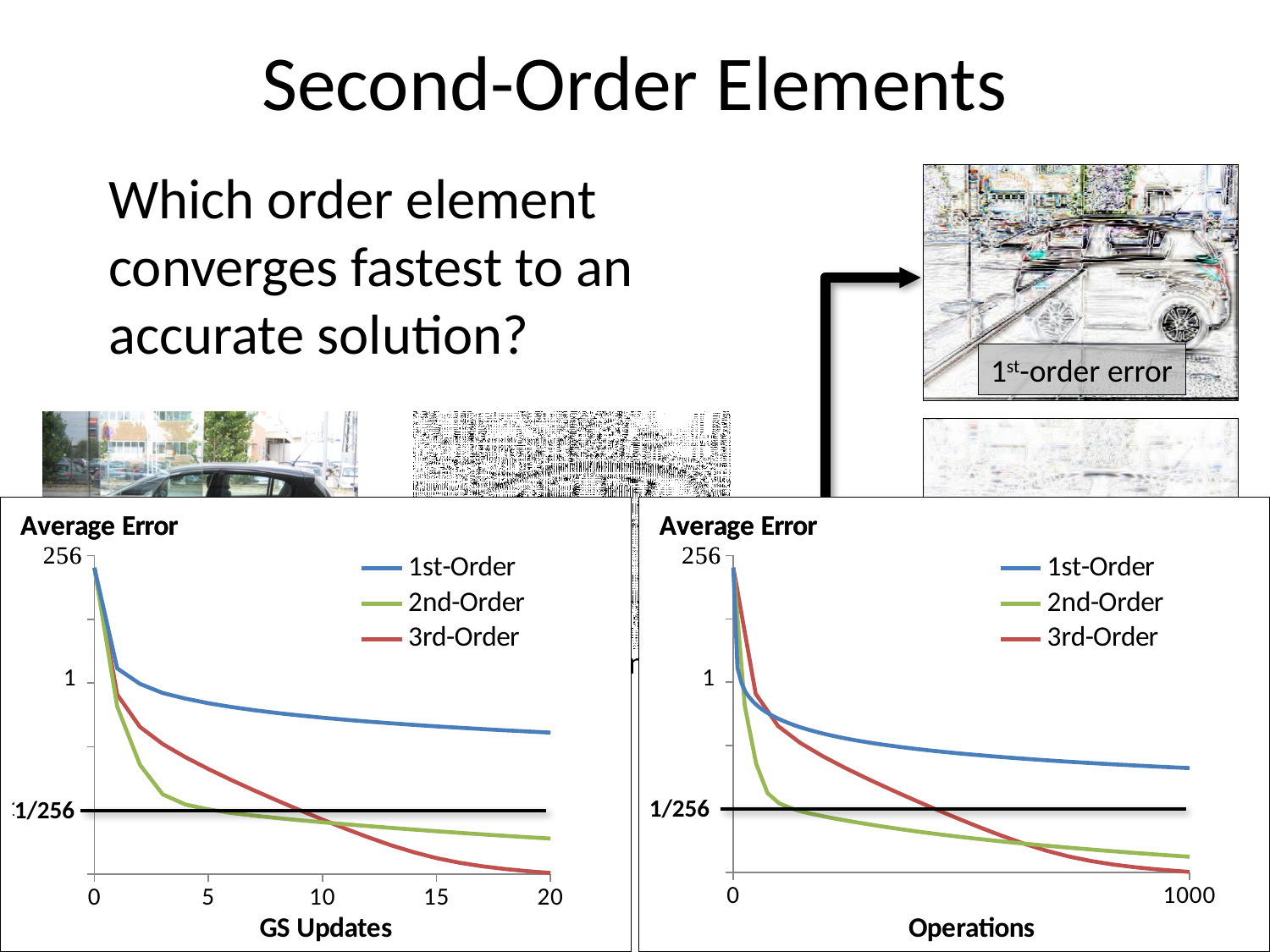
In the right chart (Operations), at 1000 Operations, which is larger: the 2nd-Order or the 1st-Order average error? 1st-Order In the left chart (GS Updates), which series has the lowest average error at 20 GS Updates? 3rd-Order What kind of chart is the left chart with x axis 'GS Updates'? line chart In the left chart (GS Updates), which series has the highest average error at 20 GS Updates? 1st-Order How many series does the legend of the left chart (GS Updates) list? 3 In the right chart (Operations), do the values of the 3rd-Order series rise or fall as Operations increase? fall What are the legend entries of the right chart (Operations)? 1st-Order, 2nd-Order, 3rd-Order What is the x-axis label of the right chart? Operations In the right chart (Operations), which series has the highest average error at 1000 Operations? 1st-Order In the left chart (GS Updates), is the 3rd-Order average error at 20 GS Updates greater or less than 1/256? less In the left chart (GS Updates), do the values of the 1st-Order series rise or fall as GS Updates increase? fall In the left chart (GS Updates), is the 1st-Order average error at 20 GS Updates greater or less than 1? less